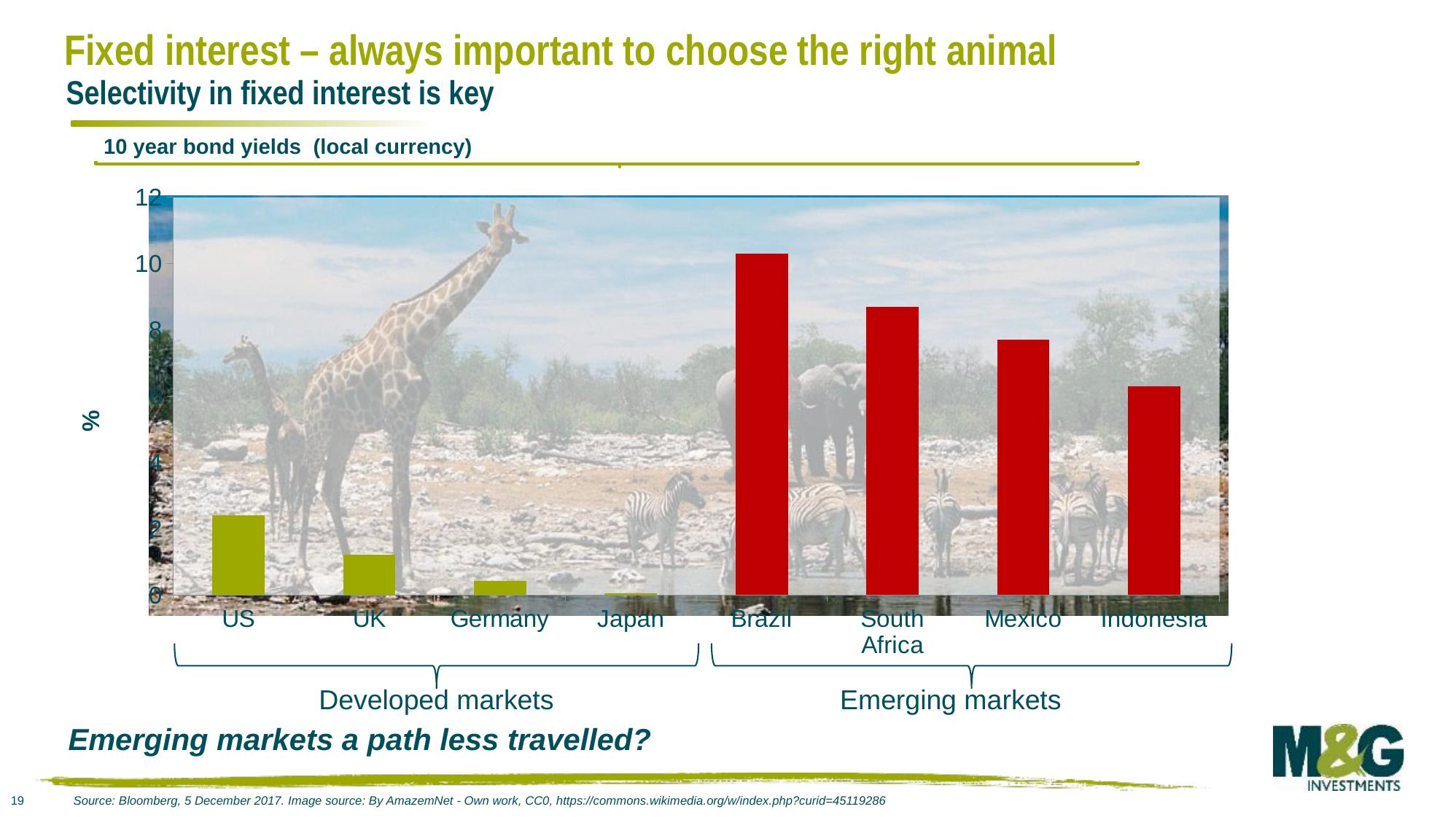
Which country has the highest 10 year bond yield in the chart? Brazil What label is shown on the y axis of the chart? % What is the title of the chart? 10 year bond yields (local currency) Is the 10 year bond yield for Brazil greater or less than 8? greater How many countries are shown on the x axis of the chart? 8 Is the 10 year bond yield for UK greater or less than 2? less Which has the higher 10 year bond yield, Mexico or Indonesia? Mexico Which has the higher 10 year bond yield, UK or Germany? UK Is the 10 year bond yield for Indonesia greater or less than 8? less What kind of chart is shown on the slide? bar chart Which country has the lowest 10 year bond yield in the chart? Japan